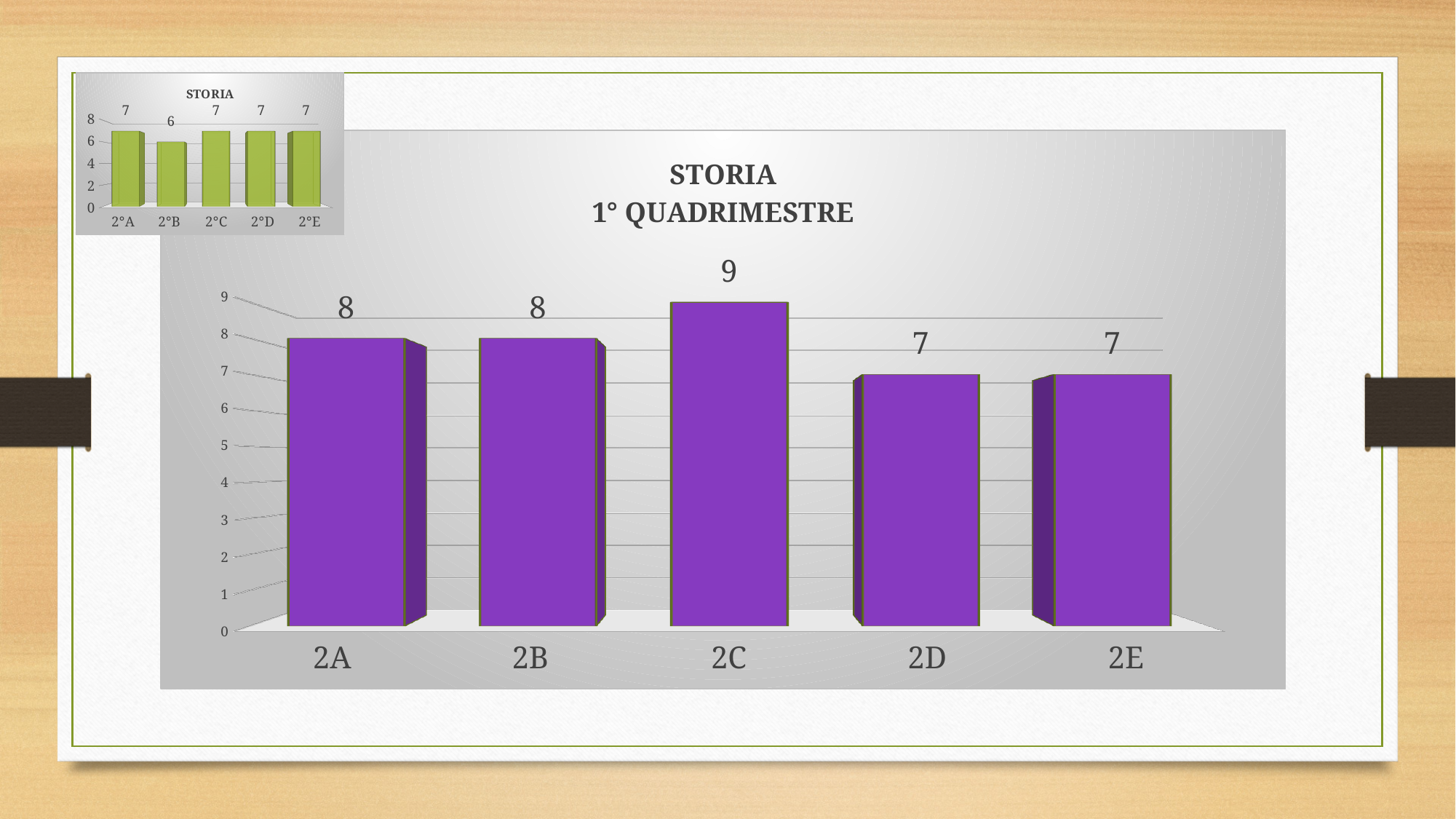
What kind of chart is the large 'STORIA 1° QUADRIMESTRE' chart? Bar chart In the large 'STORIA 1° QUADRIMESTRE' chart, which category has the highest value? 2C In the small 'STORIA' chart at the top left, what is the value for 2°B? 6 In the large 'STORIA 1° QUADRIMESTRE' chart, what is the value for 2A? 8 In the large 'STORIA 1° QUADRIMESTRE' chart, what is the value for 2C? 9 In the small 'STORIA' chart at the top left, what is the difference between the values for 2°A and 2°B? 1 In the large 'STORIA 1° QUADRIMESTRE' chart, which is larger, the value for 2B or the value for 2E? 2B What colour are the bars in the large 'STORIA 1° QUADRIMESTRE' chart? Purple In the small 'STORIA' chart at the top left, which category has the lowest value? 2°B In the large 'STORIA 1° QUADRIMESTRE' chart, how many categories are shown on the x axis? 5 In the small 'STORIA' chart at the top left, how many bars are there? 5 In the large 'STORIA 1° QUADRIMESTRE' chart, what is the difference between the values for 2C and 2D? 2